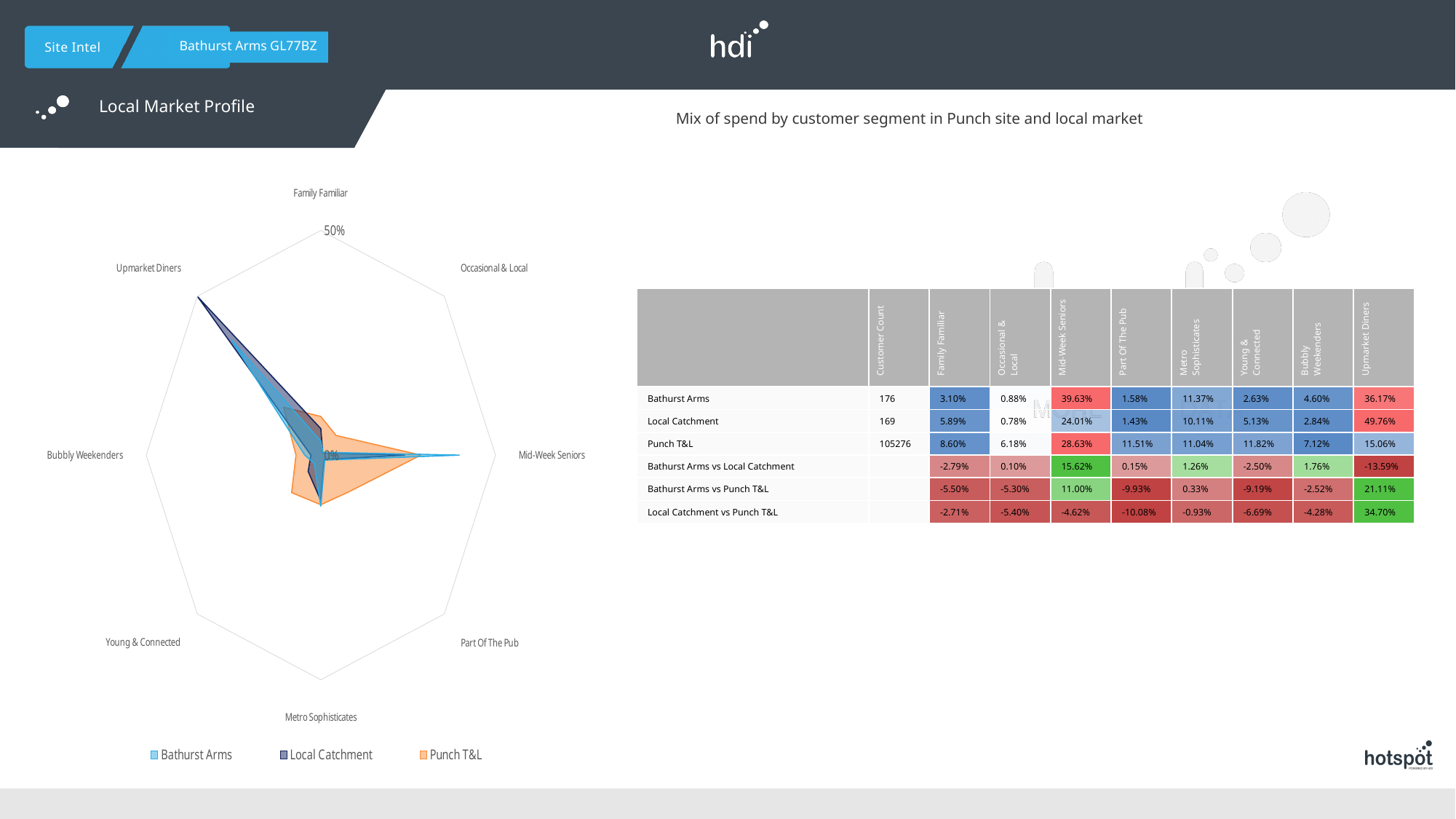
Which series in the radar chart legend is shown in orange? Punch T&L According to the table, what is the Customer Count for Punch T&L? 105276 According to the table, what is the Mid-Week Seniors value for Bathurst Arms? 39.63% Which is larger for Upmarket Diners: the Bathurst Arms value or the Punch T&L value? Bathurst Arms What kind of chart is shown on the left of the slide? Radar chart How many customer segment categories are plotted on the radar chart? 8 Which customer segment has the lowest value for Bathurst Arms? Occasional & Local According to the table, what is the Upmarket Diners value for Local Catchment? 49.76% What is the highest percentage tick shown on the radar chart axis? 50% How many series does the radar chart legend list? 3 Is the Mid-Week Seniors value for Bathurst Arms on the radar chart greater or less than 50%? less Which customer segment has the highest value for Punch T&L? Mid-Week Seniors